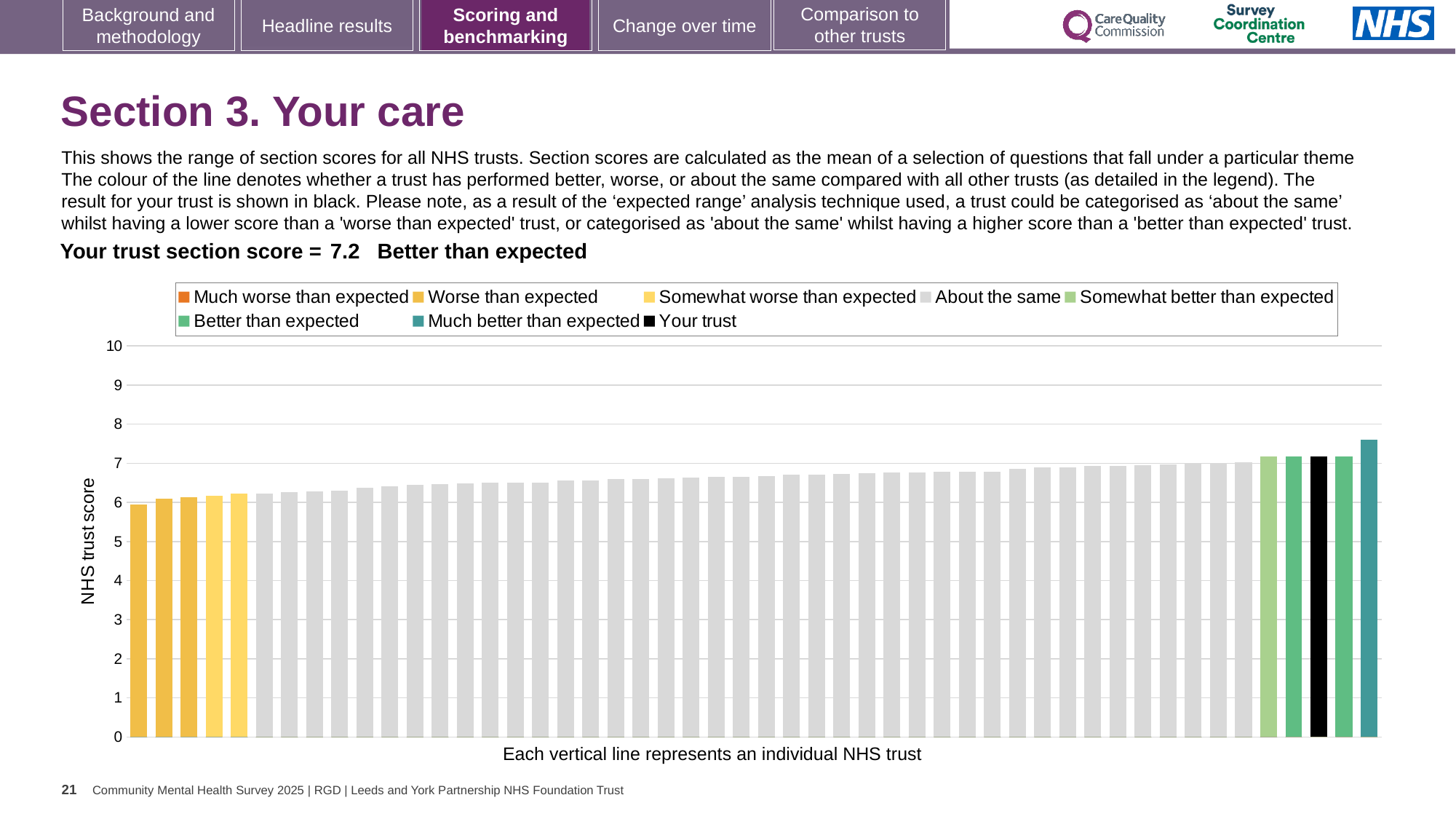
How many entries does the chart legend list? 8 What is the section score for your trust shown on the slide? 7.2 What kind of chart is shown on the slide? bar chart Do the bar values rise or fall from left to right along the x axis? rise Is the value of the leftmost bar greater or less than 7? less Is the value of the black 'Your trust' bar greater or less than 7? greater Is the value of the tallest bar (the rightmost, teal bar) greater or less than 8? less Which performance category is your trust placed in for Section 3? Better than expected Which legend category does the tallest bar belong to? Much better than expected Which legend category does the shortest bar belong to? Worse than expected How many bars are coloured teal for 'Much better than expected'? 1 What is the label on the vertical axis of the chart? NHS trust score